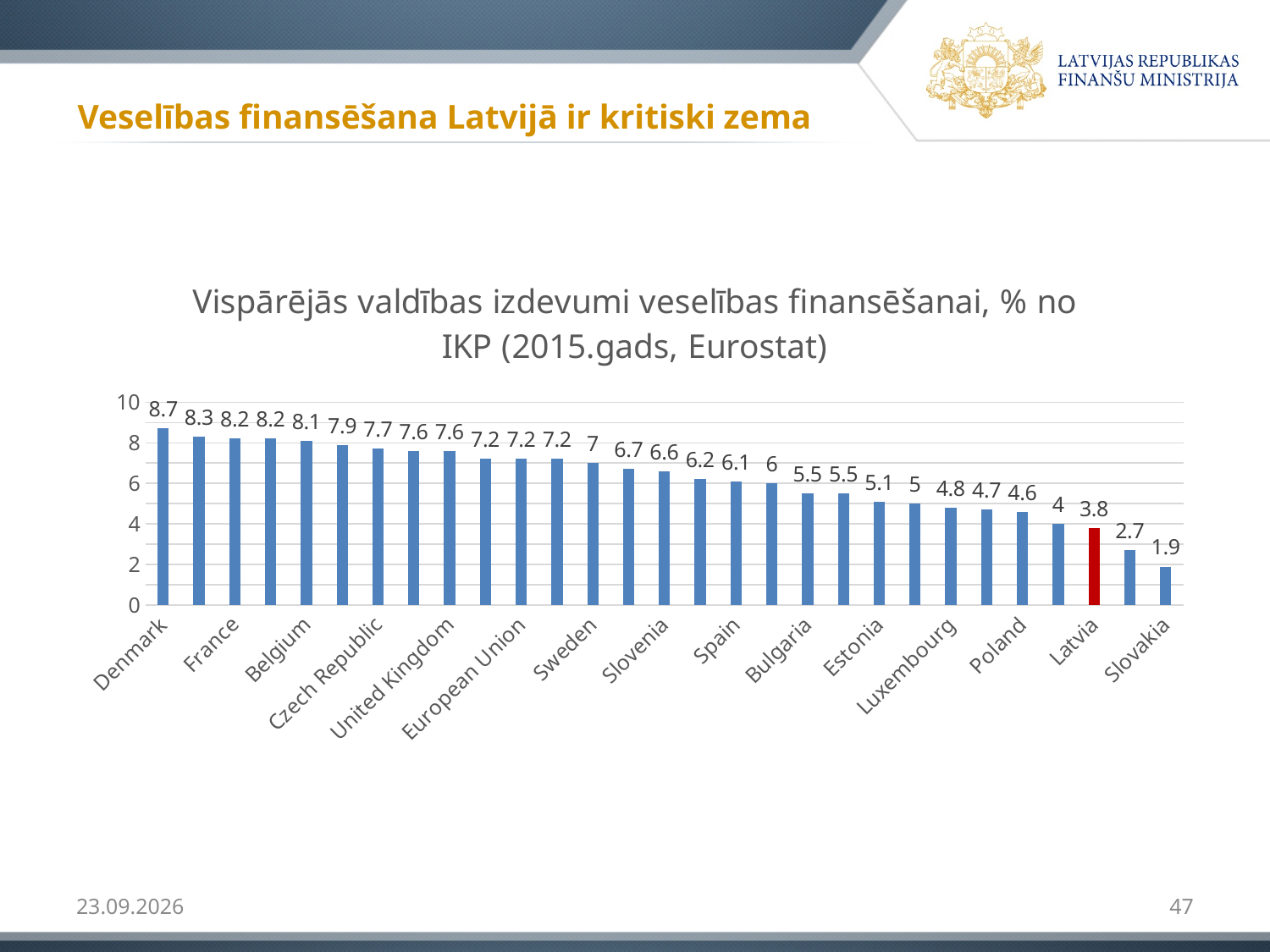
Which country has the lowest value? Slovakia Which country's bar is coloured red? Latvia What is the value for Denmark? 8.7 Which is larger, the value for Estonia or the value for Luxembourg? Estonia Which country has the highest value? Denmark What is the difference between the values for Denmark and Latvia? 4.9 What is the value for Poland? 4.6 Do the values rise or fall from left to right along the x axis? Fall What is the value for Sweden? 7 What is the value for Latvia? 3.8 What is the value for Slovakia? 1.9 What kind of chart is shown on the slide? Bar chart